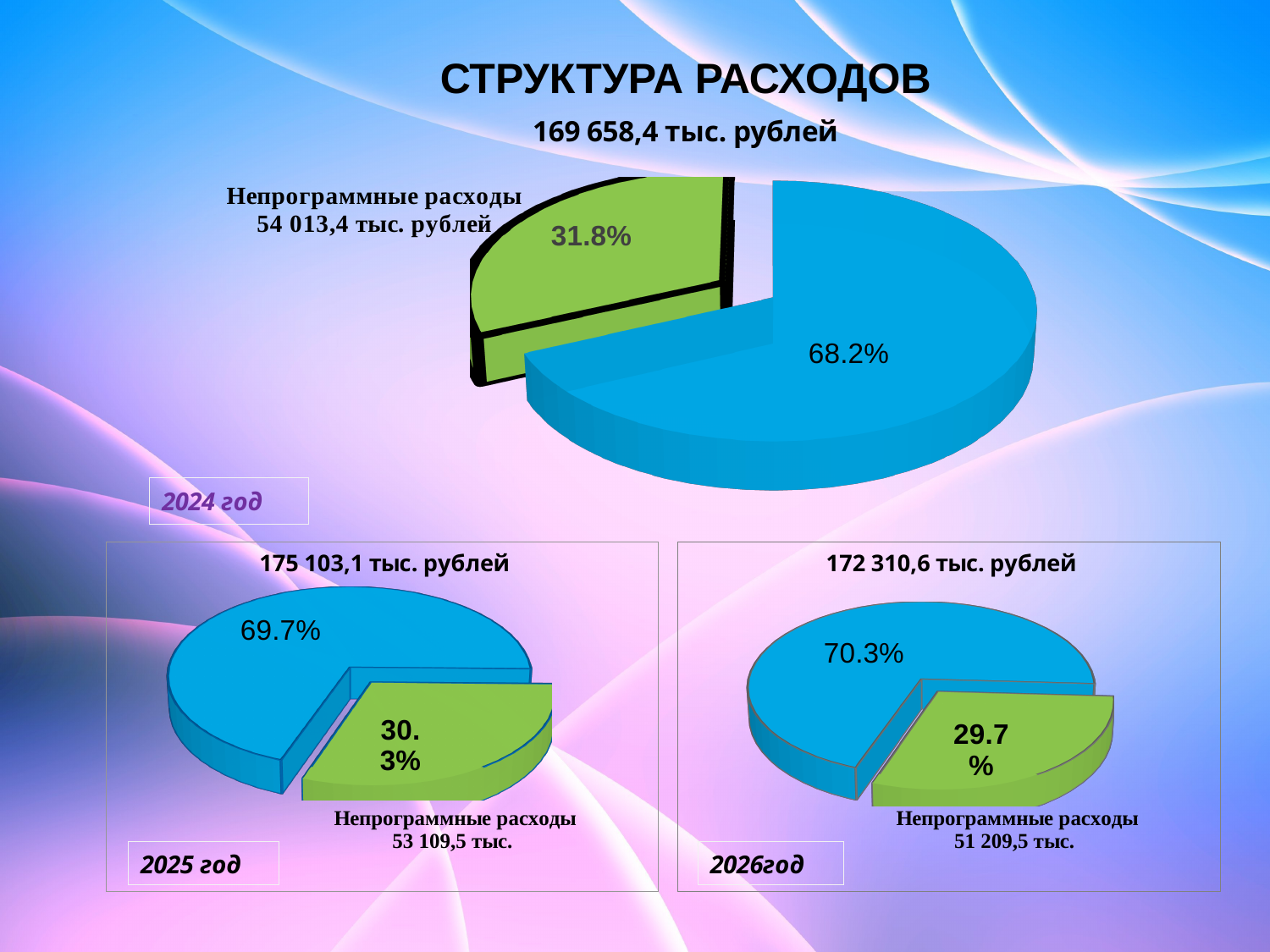
In the 2024 pie chart, what share is shown for Непрограммные расходы (the green slice)? 31.8% How many slices does the 2026 pie chart have? 2 In the 2026 pie chart, what share is shown for Непрограммные расходы (the green slice)? 29.7% What total amount is shown above the 2026 pie chart? 172 310,6 тыс. рублей In the 2026 pie chart, what percentage is shown on the blue slice? 70.3% In the 2024 pie chart, what is the difference in percentage points between the blue slice and the green slice? 36.4 In the 2025 pie chart, which slice is larger, the blue one or the green Непрограммные расходы slice? the blue one In the 2024 pie chart, what percentage is shown on the blue slice? 68.2% In the 2025 pie chart, what percentage is shown on the blue slice? 69.7% What amount of Непрограммные расходы is stated next to the 2024 pie chart? 54 013,4 тыс. рублей What type of chart is used for the 2024 expense structure? pie chart What amount of Непрограммные расходы is stated below the 2025 pie chart? 53 109,5 тыс.